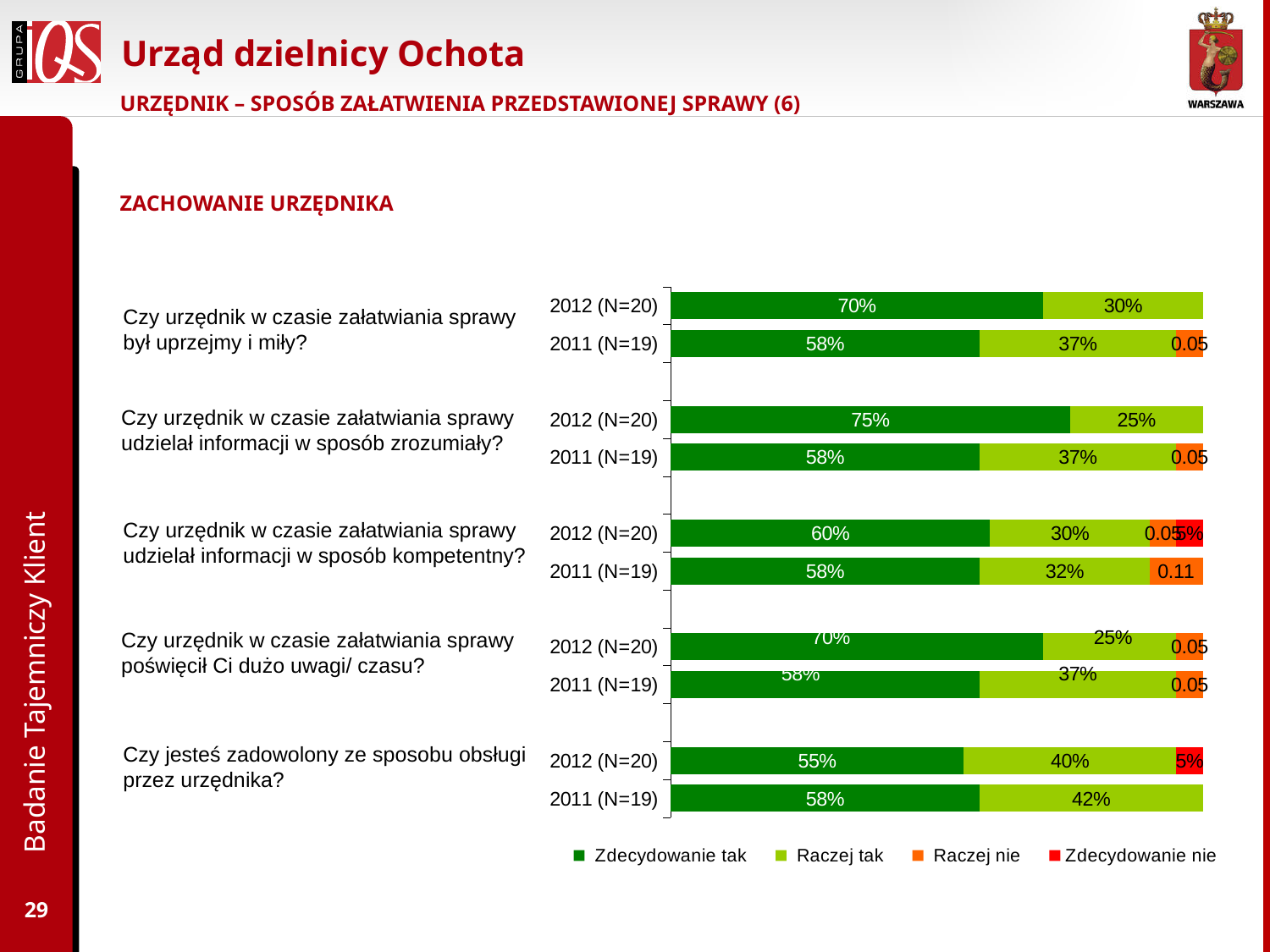
What is the 'Raczej tak' value for 2011 (N=19) for the question 'Czy urzędnik w czasie załatwiania sprawy udzielał informacji w sposób zrozumiały?' 37% What is the 'Raczej nie' value for 2011 (N=19) for the question 'Czy urzędnik w czasie załatwiania sprawy udzielał informacji w sposób kompetentny?' 0.11 What is the 'Zdecydowanie tak' value for 2012 (N=20) for the question 'Czy urzędnik w czasie załatwiania sprawy był uprzejmy i miły?' 70% How many bars are plotted in the chart? 10 Which 2012 (N=20) bar has the lowest 'Zdecydowanie tak' value? Czy jesteś zadowolony ze sposobu obsługi przez urzędnika? What kind of chart is shown on the slide? bar chart How many series does the legend list? 4 What is the 'Zdecydowanie tak' value for 2012 (N=20) for the question 'Czy urzędnik w czasie załatwiania sprawy udzielał informacji w sposób zrozumiały?' 75% Which 2012 (N=20) bar has the highest 'Zdecydowanie tak' value? Czy urzędnik w czasie załatwiania sprawy udzielał informacji w sposób zrozumiały? Which legend entry is shown in red? Zdecydowanie nie What is the difference between the 'Zdecydowanie tak' values for 2012 (N=20) and 2011 (N=19) for the question 'Czy urzędnik w czasie załatwiania sprawy udzielał informacji w sposób zrozumiały?' 17% What is the 'Raczej tak' value for 2011 (N=19) for the question 'Czy jesteś zadowolony ze sposobu obsługi przez urzędnika?' 42%